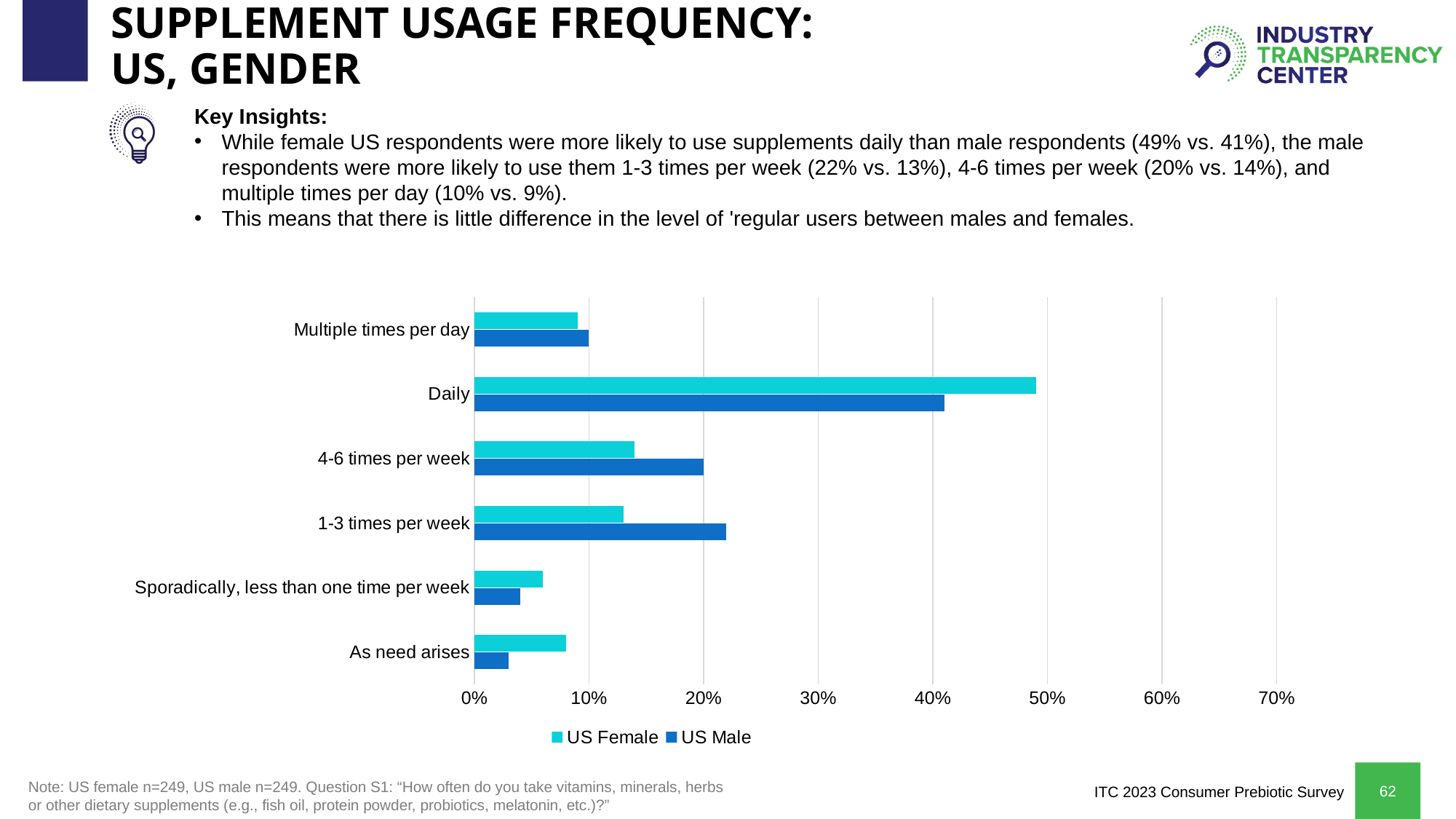
How many frequency categories are plotted on the chart? 6 Is the US Female value for Sporadically, less than one time per week greater or less than 10%? less How many series does the legend list? 2 For 1-3 times per week, which is larger: US Female or US Male? US Male Which category has the highest value for US Female? Daily What is the US Male value for 1-3 times per week? 22% Which category has the lowest value for US Male? As need arises What is the US Male value for 4-6 times per week? 20% What is the US Female value for Daily? 49% What kind of chart is shown on the slide? bar chart What is the difference between the US Female and US Male values for Daily? 8% Which colour represents US Female in the legend? light blue (cyan)